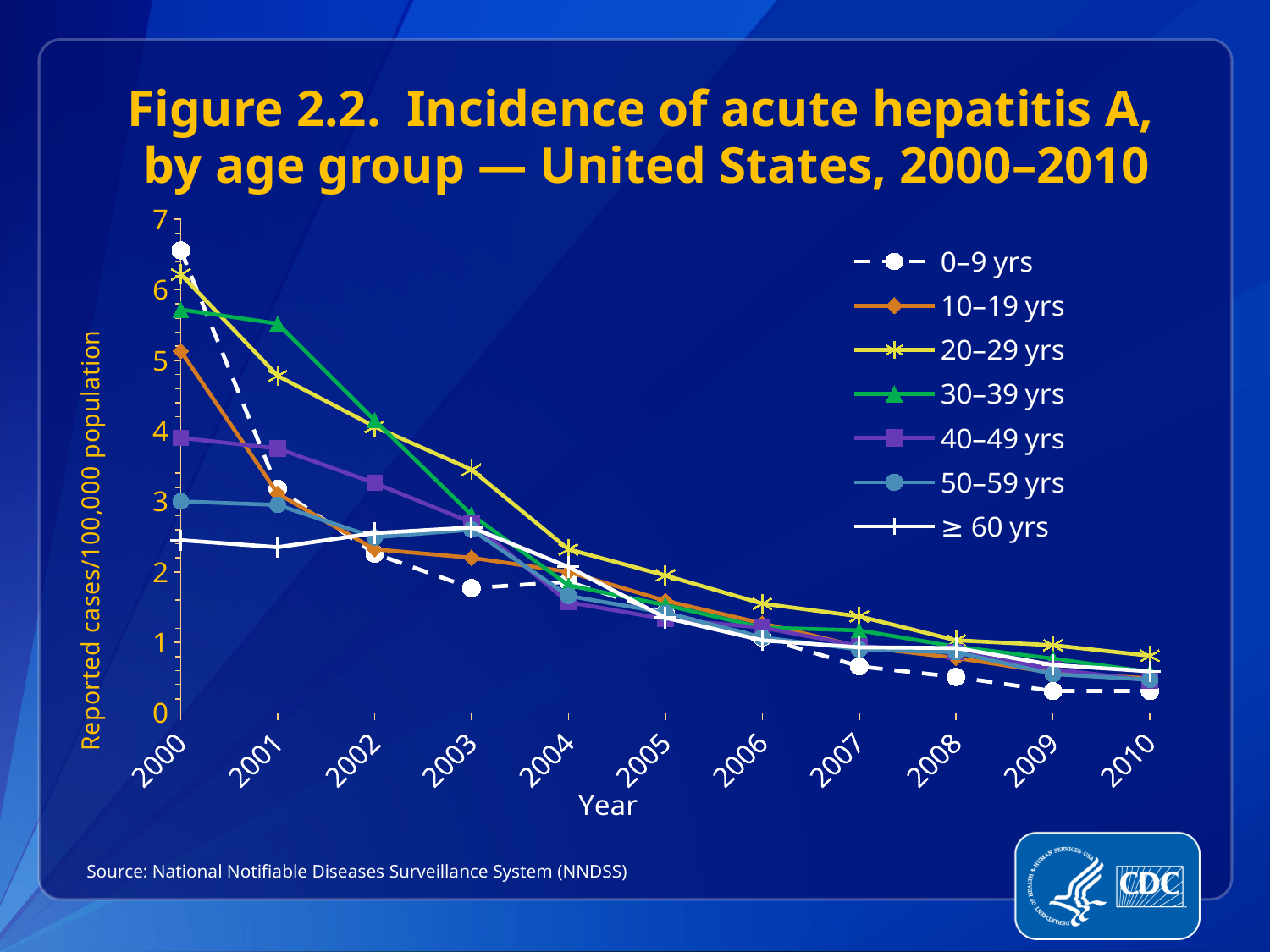
Which age group had the highest reported incidence in 2000? 0–9 yrs Does the incidence for the 20–29 yrs group rise or fall from 2000 to 2010? fall Is the value for the 0–9 yrs group in 2000 greater or less than 6? greater Is the value for the ≥ 60 yrs group in 2000 greater or less than 3? less In 2001, which had the higher incidence: the 30–39 yrs group or the 40–49 yrs group? 30–39 yrs How many years are plotted along the x axis? 11 What kind of chart is shown on the slide? line chart Which age group had the lowest reported incidence in 2000? ≥ 60 yrs How many age-group series does the legend list? 7 What is the label of the y axis? Reported cases/100,000 population Is the value for the 20–29 yrs group in 2010 greater or less than 1? less Which age group had the highest reported incidence in 2010? 20–29 yrs